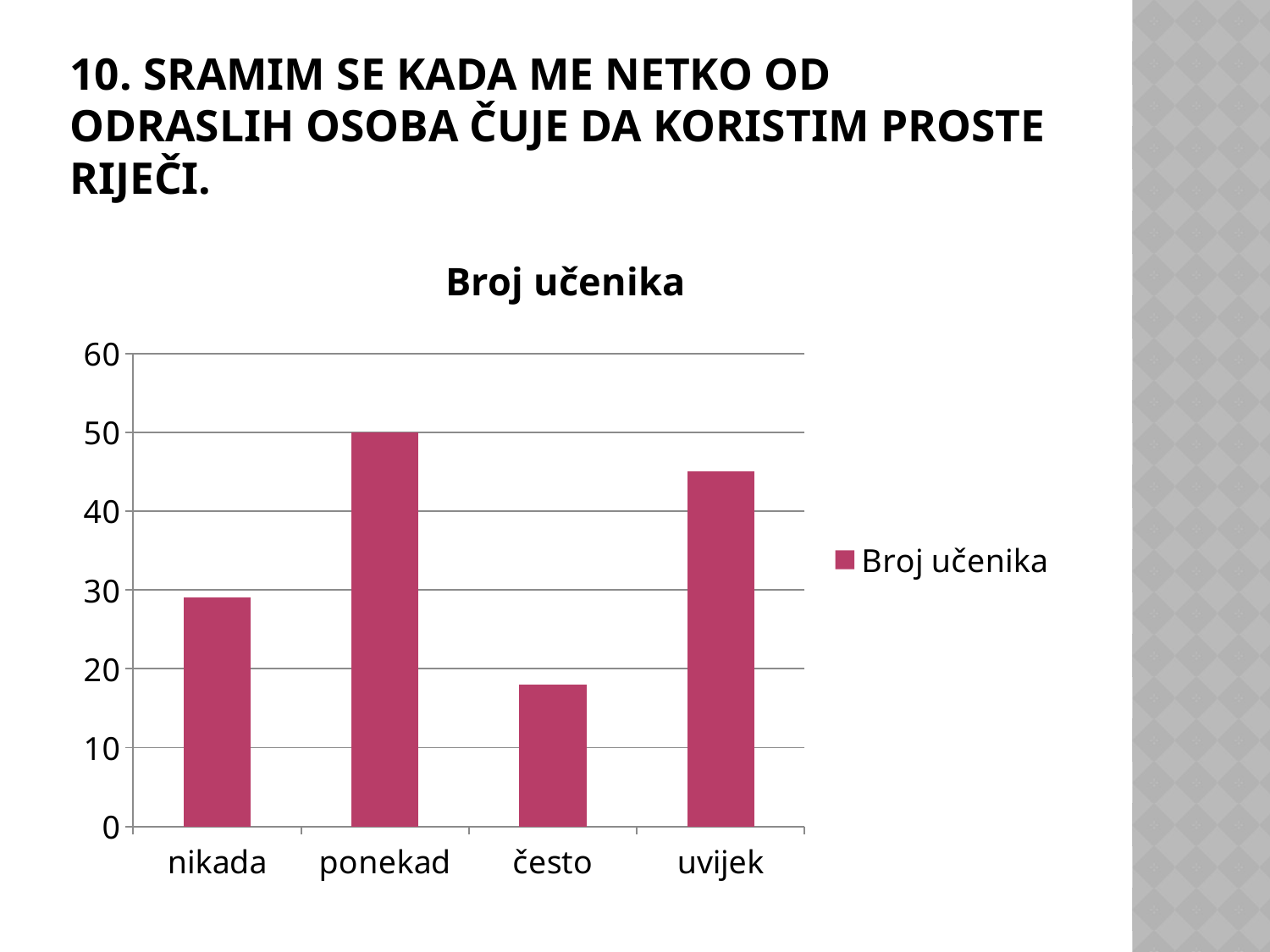
What type of chart is shown on the slide? bar chart Is the value for često greater or less than 20? less Which is larger, the value for nikada or the value for uvijek? uvijek How many series does the legend list? 1 How many categories are shown on the x axis of the chart? 4 Which category has the highest value? ponekad What is the title of the chart? Broj učenika Which category has the lowest value? često Is the value for uvijek greater or less than 40? greater Which is larger, the value for često or the value for nikada? nikada What is the value for ponekad? 50